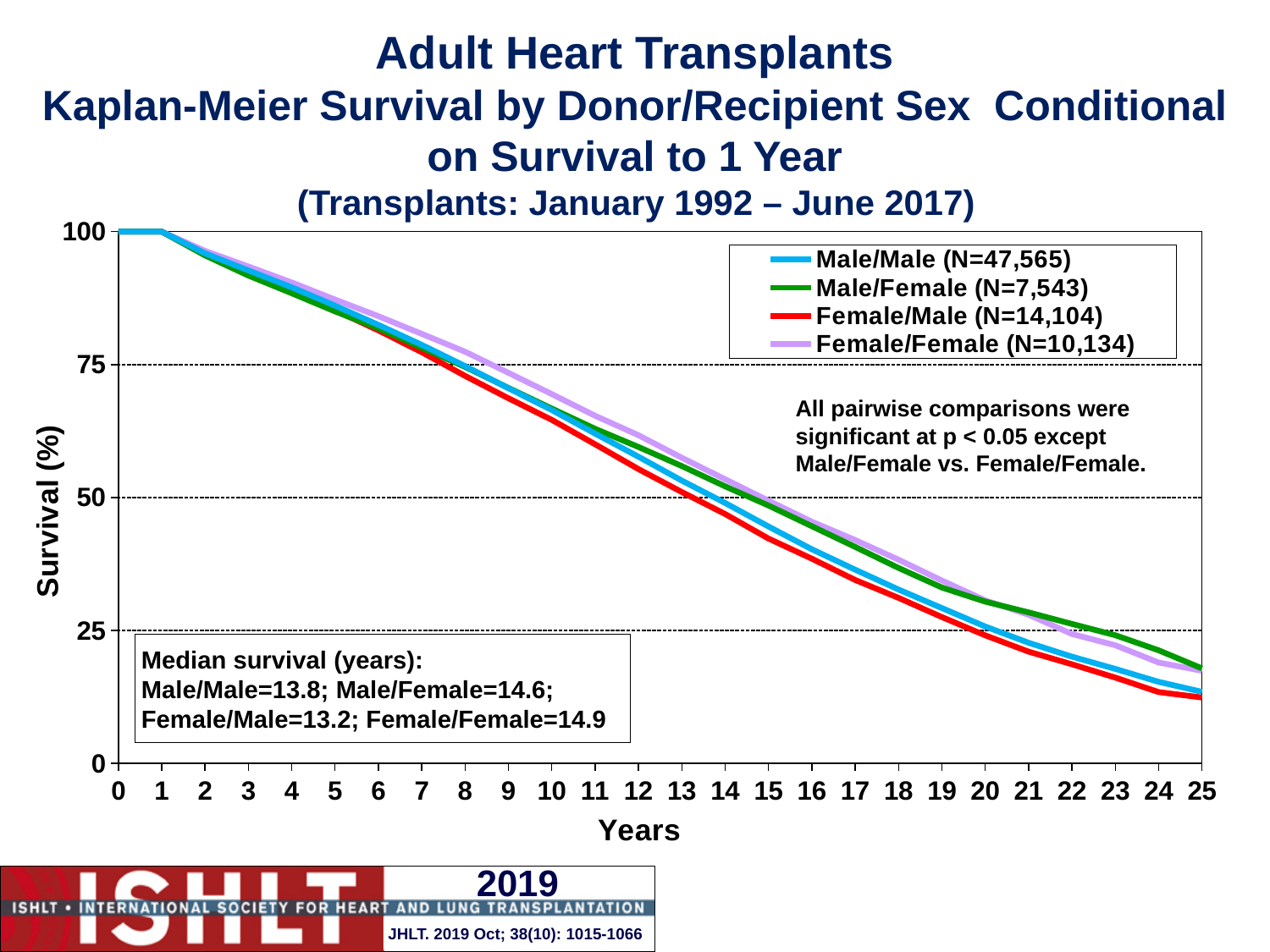
Is the survival for Female/Male at 25 years greater or less than 25? less Is the survival for Male/Male at 5 years greater or less than 75? greater What is the difference in median survival (years) between Female/Female and Female/Male? 1.7 What is the N for the Female/Male group shown in the legend? 14,104 Which donor/recipient group has the highest median survival? Female/Female Which group has the lowest survival curve at 25 years? Female/Male Which donor/recipient group has the lowest median survival? Female/Male What is the median survival in years for Male/Male? 13.8 Do the survival curves rise or fall as years increase? fall What is the median survival in years for Female/Female? 14.9 What kind of chart is shown on the slide? line chart How many series does the legend list? 4